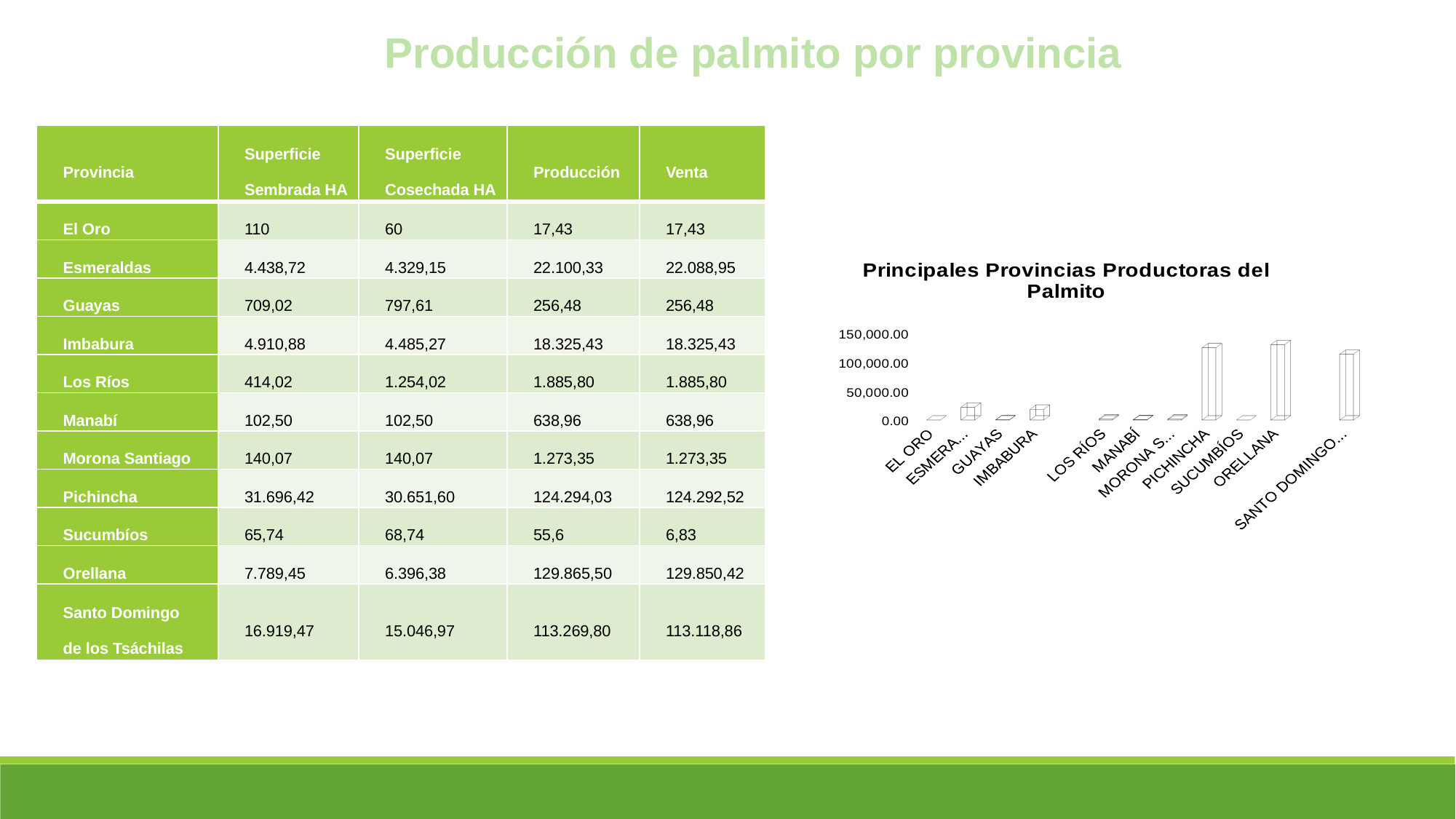
In the chart, which has the larger value, LOS RÍOS or ORELLANA? ORELLANA In the chart, is the value for IMBABURA greater or less than 50,000.00? less In the chart, is the value for ORELLANA greater or less than 100,000.00? greater How many provinces are shown on the x axis of the chart? 11 In the chart, is the value for SANTO DOMINGO greater or less than 100,000.00? greater What kind of chart is shown on the slide? bar chart What is the highest value shown on the chart's vertical axis? 150,000.00 In the chart, which has the larger value, PICHINCHA or IMBABURA? PICHINCHA What is the title of the chart on the right of the slide? Principales Provincias Productoras del Palmito